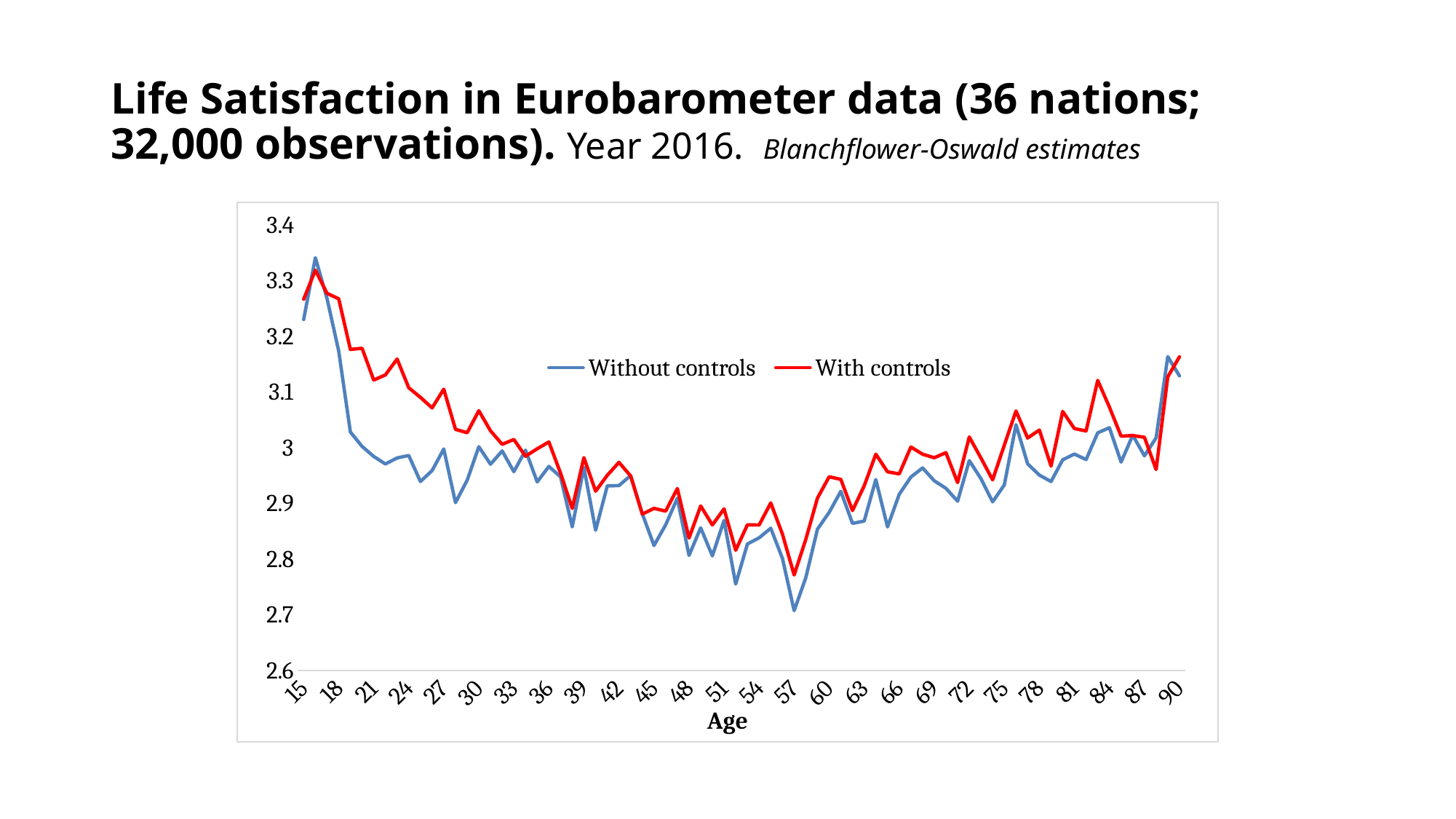
Between age 15 and age 57, does the Without controls line generally rise or fall? fall How many series does the legend list? 2 Is the value for Without controls at age 57 greater or less than 2.8? less What are the two series named in the legend? Without controls and With controls What kind of chart is shown on the slide? Line chart At age 24, which series has the higher value, Without controls or With controls? With controls Is the value for With controls at age 15 greater or less than 3.2? greater Is the value for Without controls at age 90 greater or less than 3.1? greater At age 57, which series has the higher value, Without controls or With controls? With controls At which labelled age does the Without controls line reach its lowest value? 57 What is the title of the horizontal axis? Age